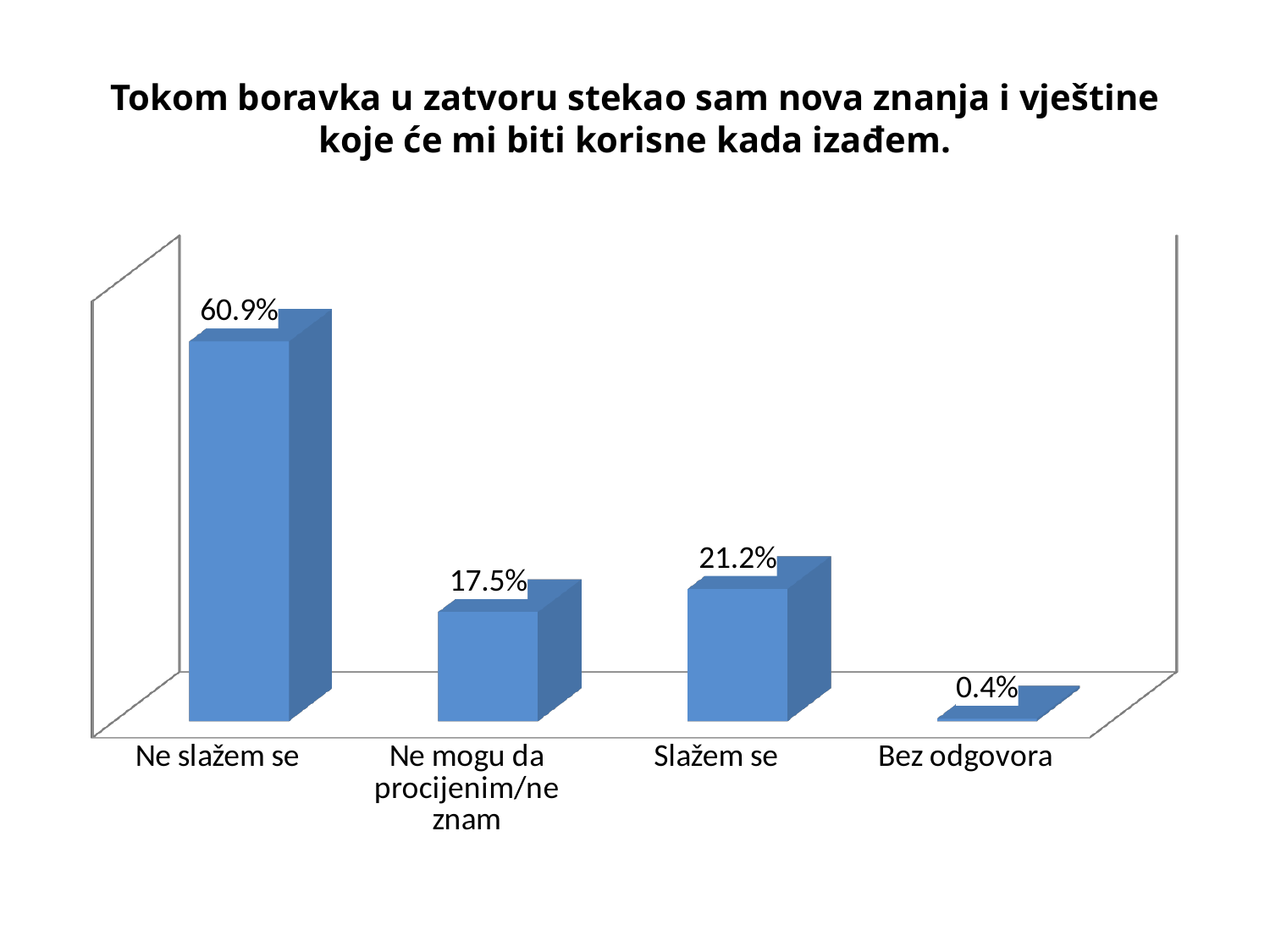
What is the value for "Ne mogu da procijenim/ne znam"? 17.5% What is the value for "Ne slažem se"? 60.9% What kind of chart is shown on the slide? Bar chart What is the title of the chart? Tokom boravka u zatvoru stekao sam nova znanja i vještine koje će mi biti korisne kada izađem. What is the difference between the values for "Slažem se" and "Ne mogu da procijenim/ne znam"? 3.7% Which category has the highest value? Ne slažem se What is the value for "Bez odgovora"? 0.4% Which is larger, the value for "Slažem se" or the value for "Ne mogu da procijenim/ne znam"? Slažem se What is the value for "Slažem se"? 21.2% What is the difference between the values for "Ne slažem se" and "Slažem se"? 39.7% How many categories are shown in the chart? 4 Which category has the lowest value? Bez odgovora